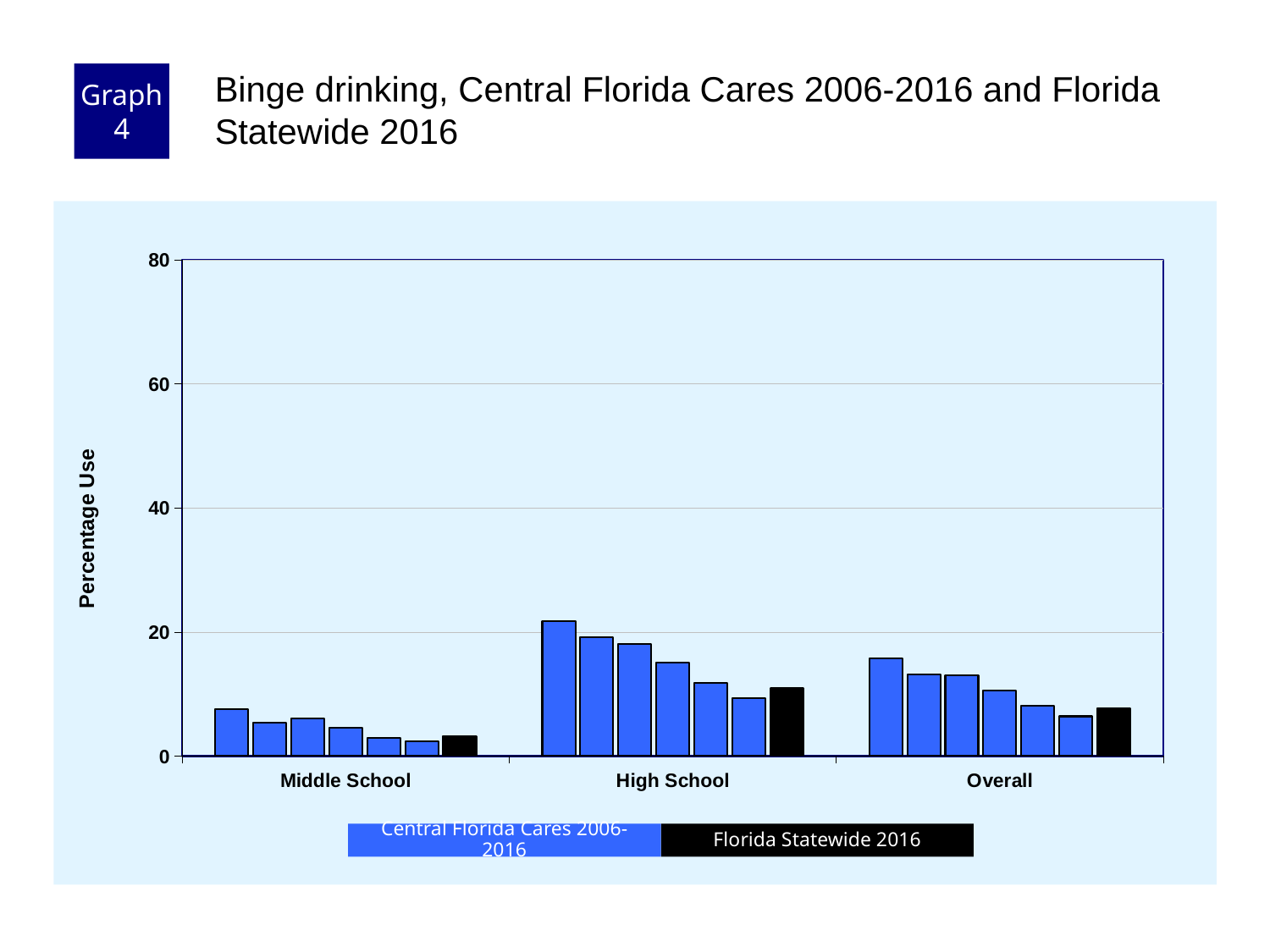
What is the label on the y axis? Percentage Use Is the Florida Statewide 2016 value for High School greater or less than 20? less Within the High School group, do the Central Florida Cares 2006-2016 bars rise or fall from left to right? fall What type of chart is shown on the slide? bar chart Is the Florida Statewide 2016 value for Overall greater or less than 20? less Are all the High School bars greater or less than 40? less How many series does the legend list? 2 Which is larger, the Florida Statewide 2016 bar for High School or the Florida Statewide 2016 bar for Middle School? High School Which category has the highest bars? High School Which category has the lowest bars? Middle School How many categories are shown along the x axis? 3